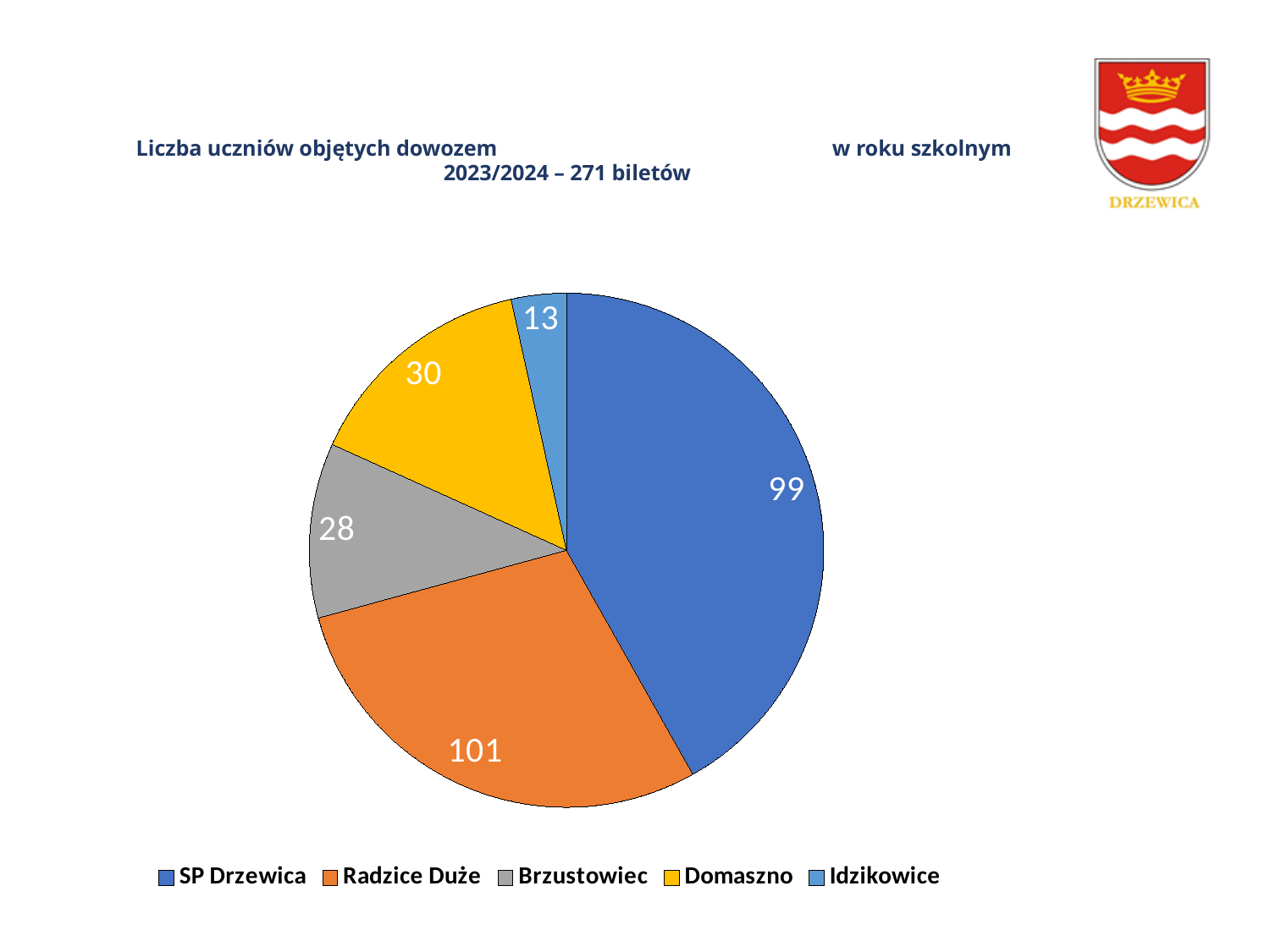
What is the total of all slices in the pie chart? 271 How many categories does the legend list? 5 How many students does the Radzice Duże slice represent? 101 What type of chart is shown on the slide? pie chart What is the difference between the values for Radzice Duże and SP Drzewica? 2 What is the value shown for SP Drzewica? 99 Which category has the smallest slice of the pie? Idzikowice What is the value shown for Idzikowice? 13 What colour is the Brzustowiec slice? gray What is the value shown for Domaszno? 30 Which is larger, the value for Domaszno or the value for Brzustowiec? Domaszno